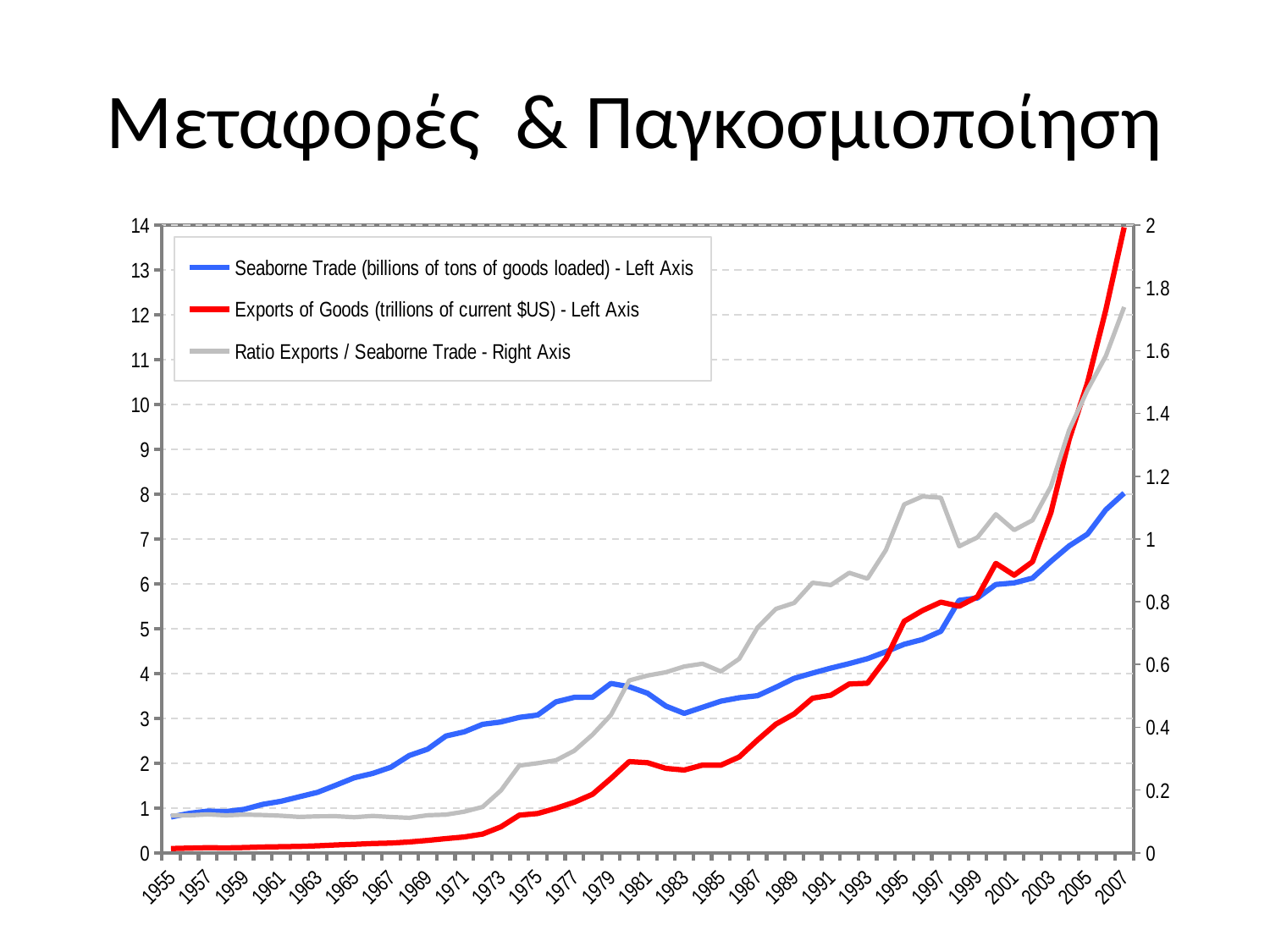
Is the value for Ratio Exports / Seaborne Trade in 1985 greater or less than 0.8 on the right axis? less Is the value for Ratio Exports / Seaborne Trade in 2007 greater or less than 1.6 on the right axis? greater Is the value for Exports of Goods in 1973 greater or less than 1? less What colour is the line for Exports of Goods (trillions of current $US)? red Which series is plotted against the right axis? Ratio Exports / Seaborne Trade How many series does the legend list? 3 What kind of chart is shown on the slide? line chart Does the Exports of Goods line generally rise or fall from 1955 to 2007? rise In 2007, which is larger on the left axis: Seaborne Trade or Exports of Goods? Exports of Goods In 1975, which is larger on the left axis: Seaborne Trade or Exports of Goods? Seaborne Trade